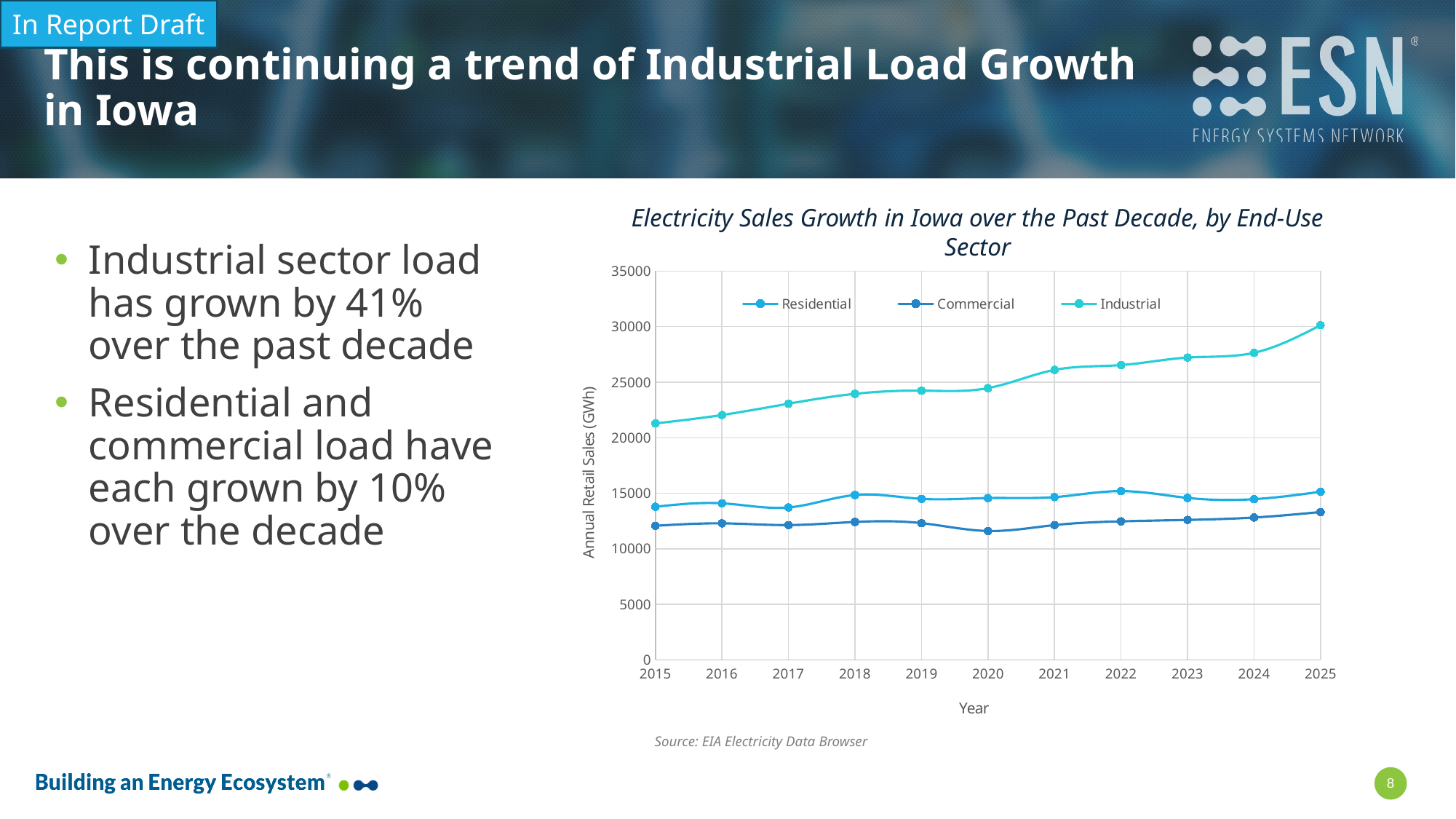
Is the Residential value for 2015 greater or less than 15000? less What is the label of the y axis? Annual Retail Sales (GWh) Which series has the highest value in 2025? Industrial What kind of chart is shown on the slide? Line chart Does the Industrial series rise or fall from 2015 to 2025? Rise Which is larger in 2018, the Residential value or the Commercial value? Residential How many years are plotted along the x axis? 11 Which series has the lowest value in 2020? Commercial In which year is the Industrial series at its highest? 2025 Is the Industrial value for 2021 greater or less than 25000? greater In which year is the Commercial series at its lowest? 2020 How many series does the legend list? 3